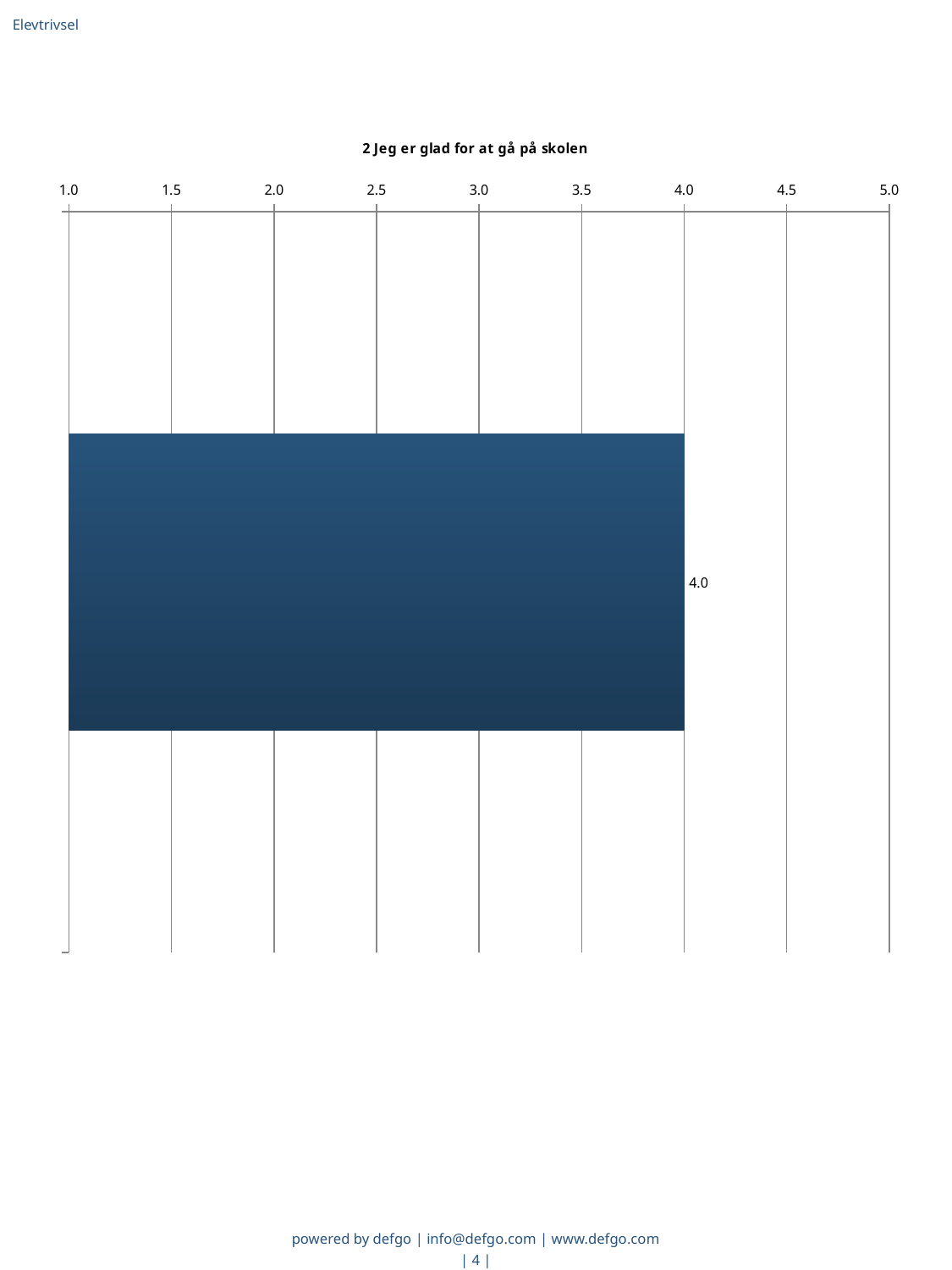
Is the bar in the chart horizontal or vertical? horizontal Is the value of the bar greater or less than 3.5? greater What is the highest value shown on the chart's axis? 5.0 How many bars are plotted in the chart? 1 What is the lowest value shown on the chart's axis? 1.0 What is the value shown by the bar in the chart titled "2 Jeg er glad for at gå på skolen"? 4.0 Is the value of the bar greater or less than 4.5? less What is the title of the chart? 2 Jeg er glad for at gå på skolen What kind of chart is shown on the slide? bar chart